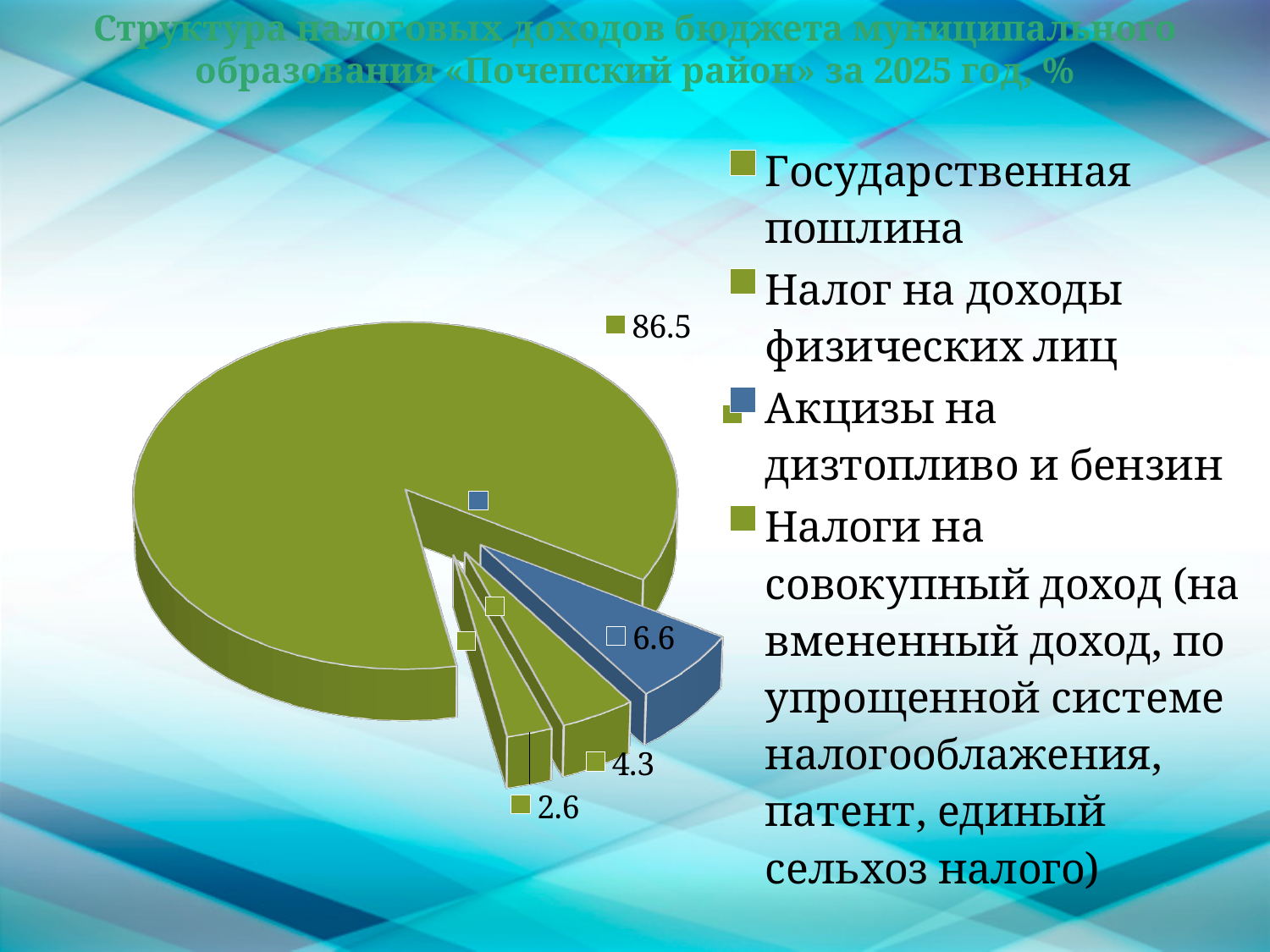
What kind of chart is shown on the slide? pie chart Which is larger: the slice labelled 4.3 or the slice labelled 2.6? 4.3 Which legend entry is shown in blue rather than green? Акцизы на дизтопливо и бензин What is the title of the chart? Структура налоговых доходов бюджета муниципального образования «Почепский район» за 2025 год, % What is the smallest value labelled on the pie chart? 2.6 Is the value for Акцизы на дизтопливо и бензин greater or less than 10? less What is the difference between the largest slice (86.5) and the slice for Акцизы на дизтопливо и бензин (6.6)? 79.9 What is the value of the blue slice, Акцизы на дизтопливо и бензин? 6.6 What is the sum of all four values labelled on the pie chart? 100.0 How many entries does the legend list? 4 What is the largest value labelled on the pie chart? 86.5 How many slices does the pie chart have? 4